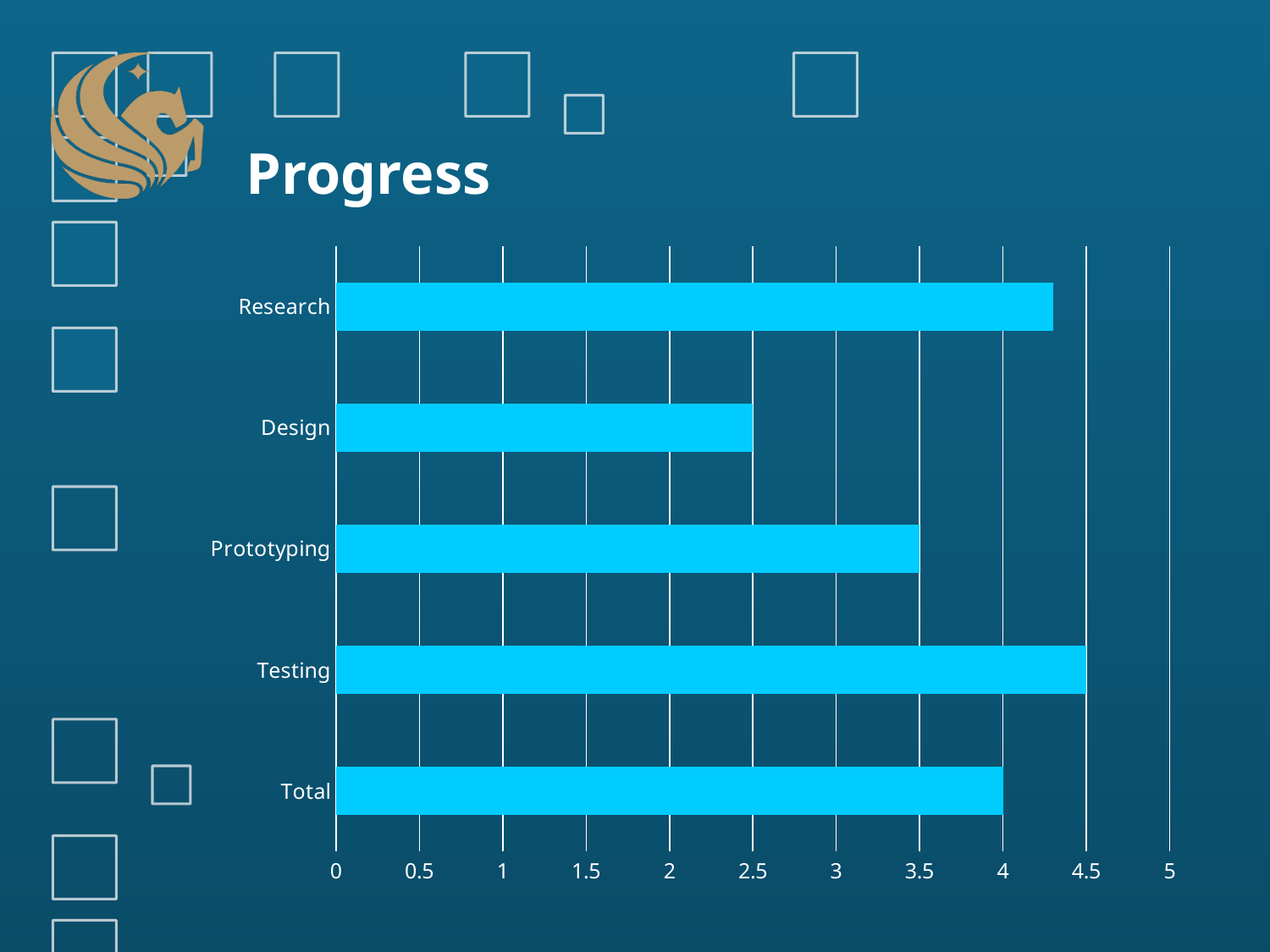
What is the value for Testing? 4.5 What is the value for Prototyping? 3.5 What is the value for Total? 4 Which is larger, the value for Prototyping or the value for Design? Prototyping Which category has the lowest value? Design What is the value for Design? 2.5 How many categories are plotted in the chart? 5 Is the value for Research greater or less than 4? greater What is the difference between the values for Testing and Design? 2 What is the title of the slide containing the chart? Progress Which category has the highest value? Testing What kind of chart is shown on the slide? bar chart